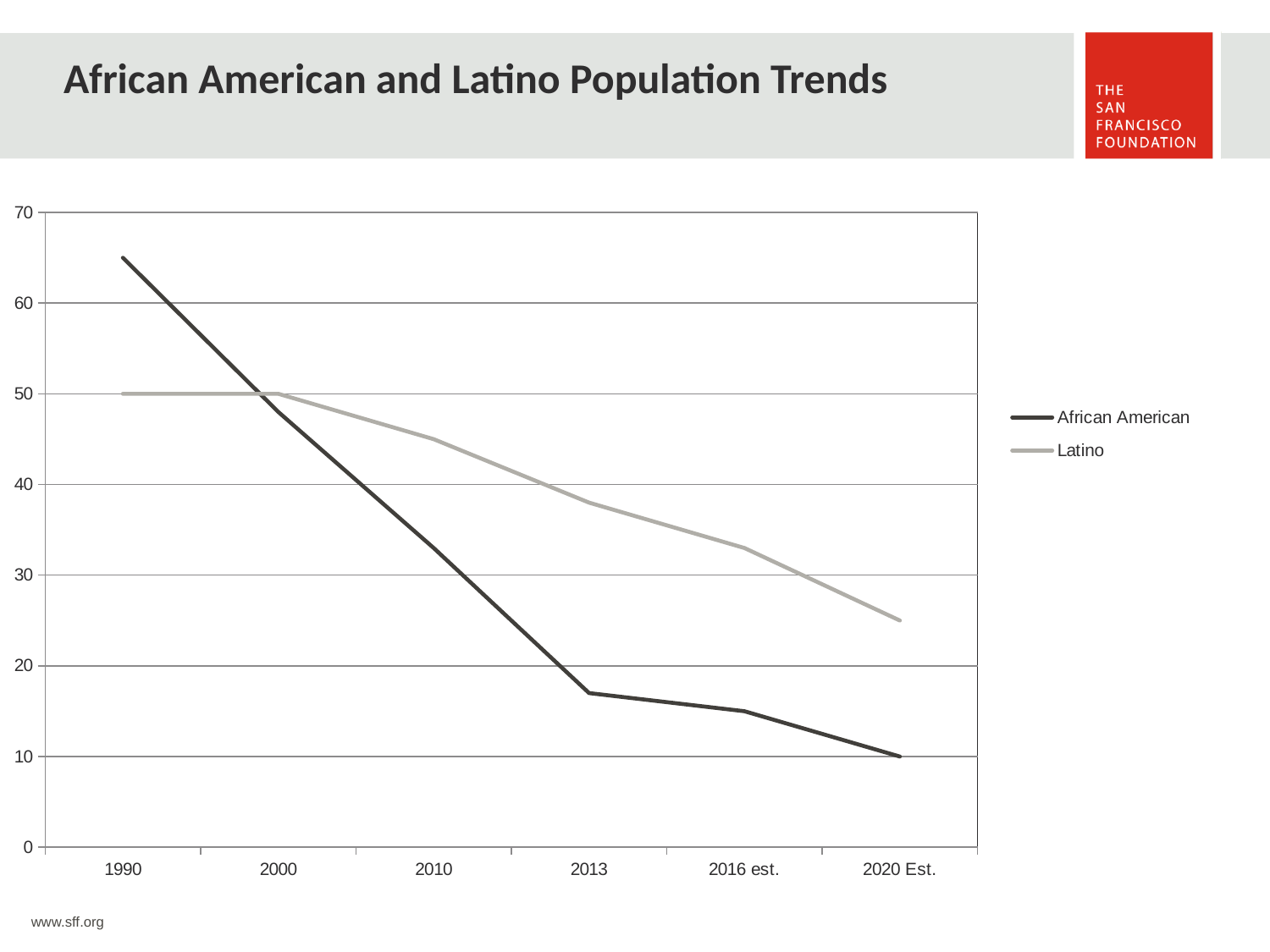
In 2013, which series has the larger value, African American or Latino? Latino How many series does the legend list? 2 What is the value for African American in 2020 Est.? 10 Is the value for African American in 2013 greater or less than 20? less Is the value for Latino in 2010 greater or less than 40? greater Is the value for Latino in 2020 Est. greater or less than 20? greater In 1990, which series has the larger value, African American or Latino? African American What is the value for Latino in 1990? 50 Do the African American values rise or fall from 1990 to 2020 Est.? fall What kind of chart is shown on the slide? line chart How many points are plotted along the x axis for each series? 6